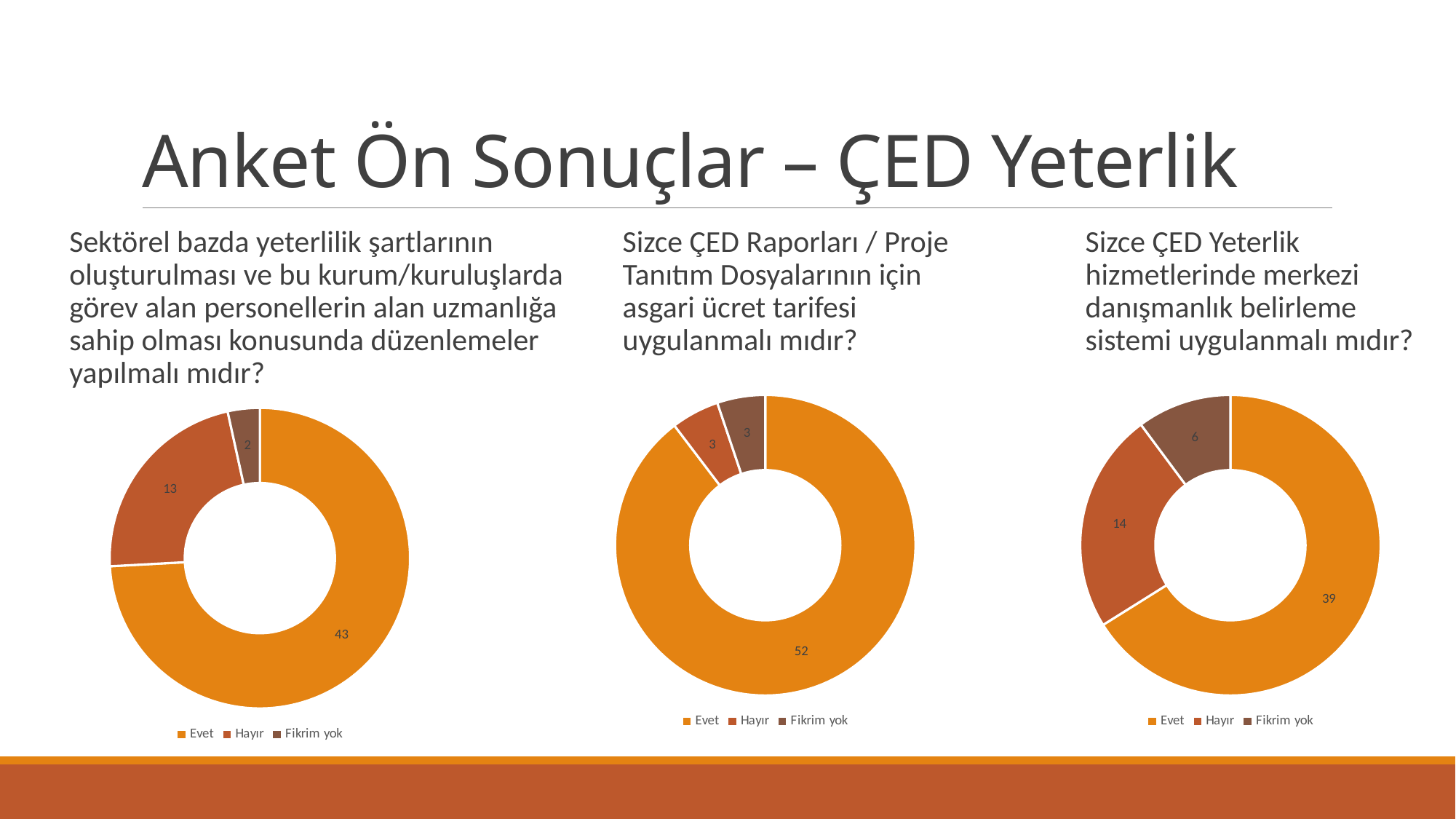
In the right chart, what is the value for Fikrim yok? 6 What is the total of all values in the middle chart? 58 In the left chart, what is the value for Hayır? 13 In the right chart, what is the difference between the values for Hayır and Fikrim yok? 8 In the middle chart, what is the value for Evet? 52 In the right chart, which category has the lowest value? Fikrim yok What kind of chart is the middle chart? Doughnut chart How many categories does the legend of the left chart list? 3 Which is larger: the value for Hayır in the left chart or the value for Hayır in the right chart? Hayır in the right chart In the left chart, what is the value for Evet? 43 In the middle chart, which category has the highest value? Evet In the left chart, what is the difference between the values for Evet and Hayır? 30